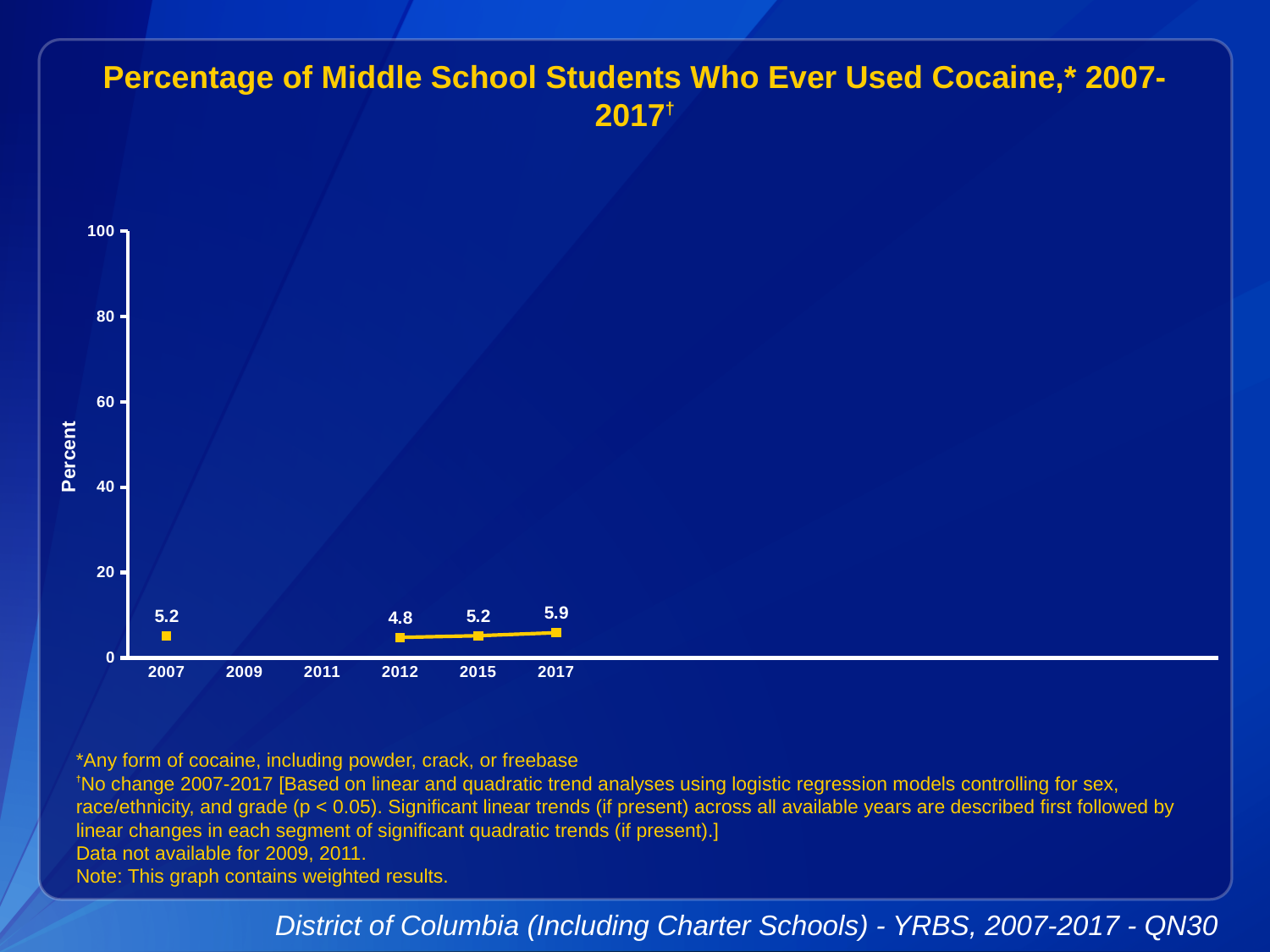
How many years have data points plotted? 4 Which year has the lowest value? 2012 What is the value for 2012? 4.8 What is the value for 2017? 5.9 What is the difference between the values for 2017 and 2012? 1.1 Is the value for 2017 greater or less than 20? less Which is larger, the value for 2017 or the value for 2015? 2017 What kind of chart is this? line chart What is the value for 2007? 5.2 Which year has the highest value? 2017 What is the label on the y axis? Percent What is the value for 2015? 5.2